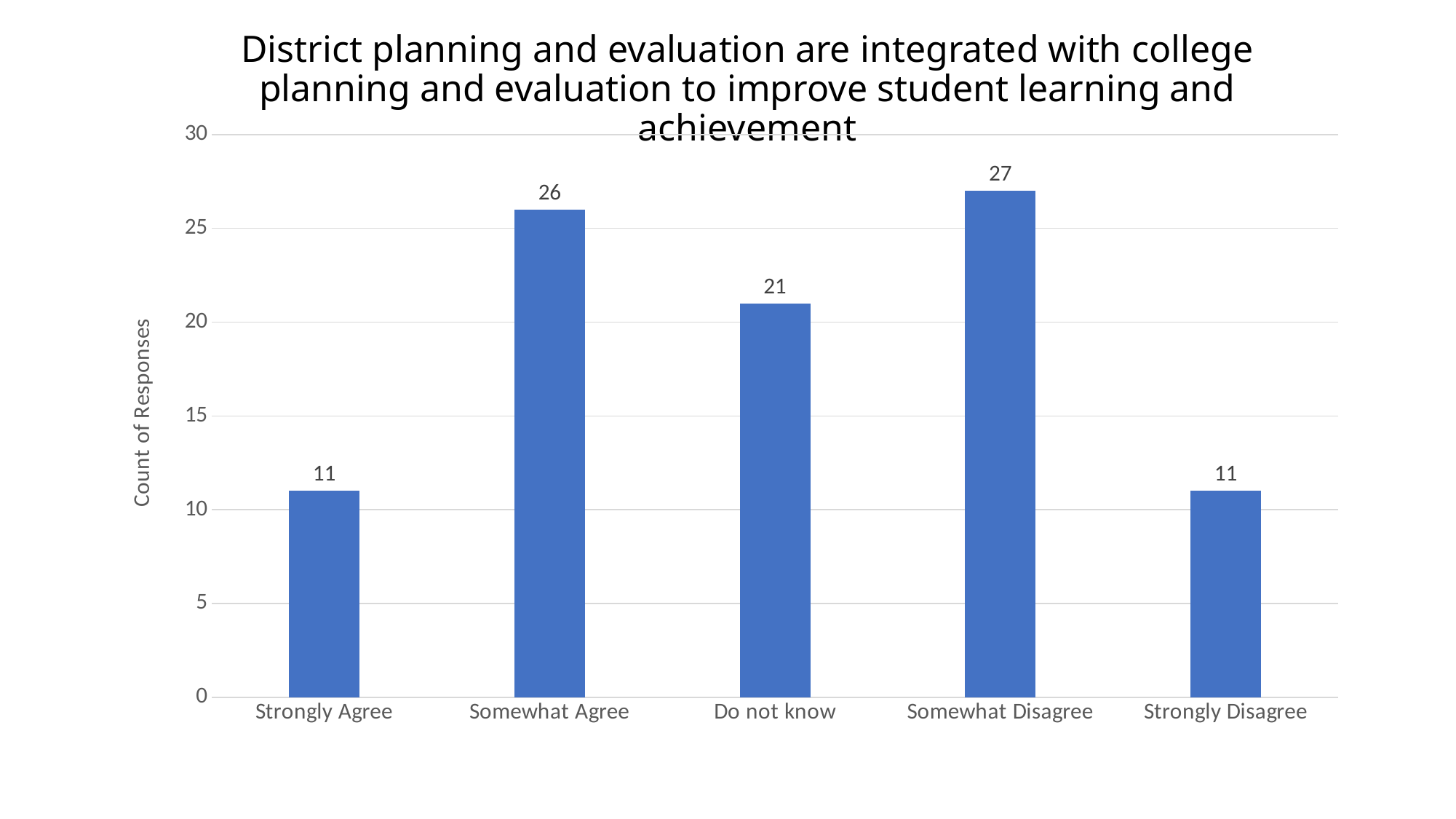
What is the count of responses for Somewhat Agree? 26 What is the count of responses for Strongly Disagree? 11 Which is larger, the count for Do not know or the count for Strongly Agree? Do not know What is the label of the vertical axis? Count of Responses What is the difference between the counts for Somewhat Disagree and Strongly Disagree? 16 What is the difference between the counts for Somewhat Agree and Do not know? 5 How many categories are shown on the x axis? 5 Is the value for Do not know greater or less than 20? greater What kind of chart is shown on the slide? Bar chart What is the difference between the counts for Somewhat Disagree and Somewhat Agree? 1 Which category has the highest count of responses? Somewhat Disagree What is the count of responses for Do not know? 21